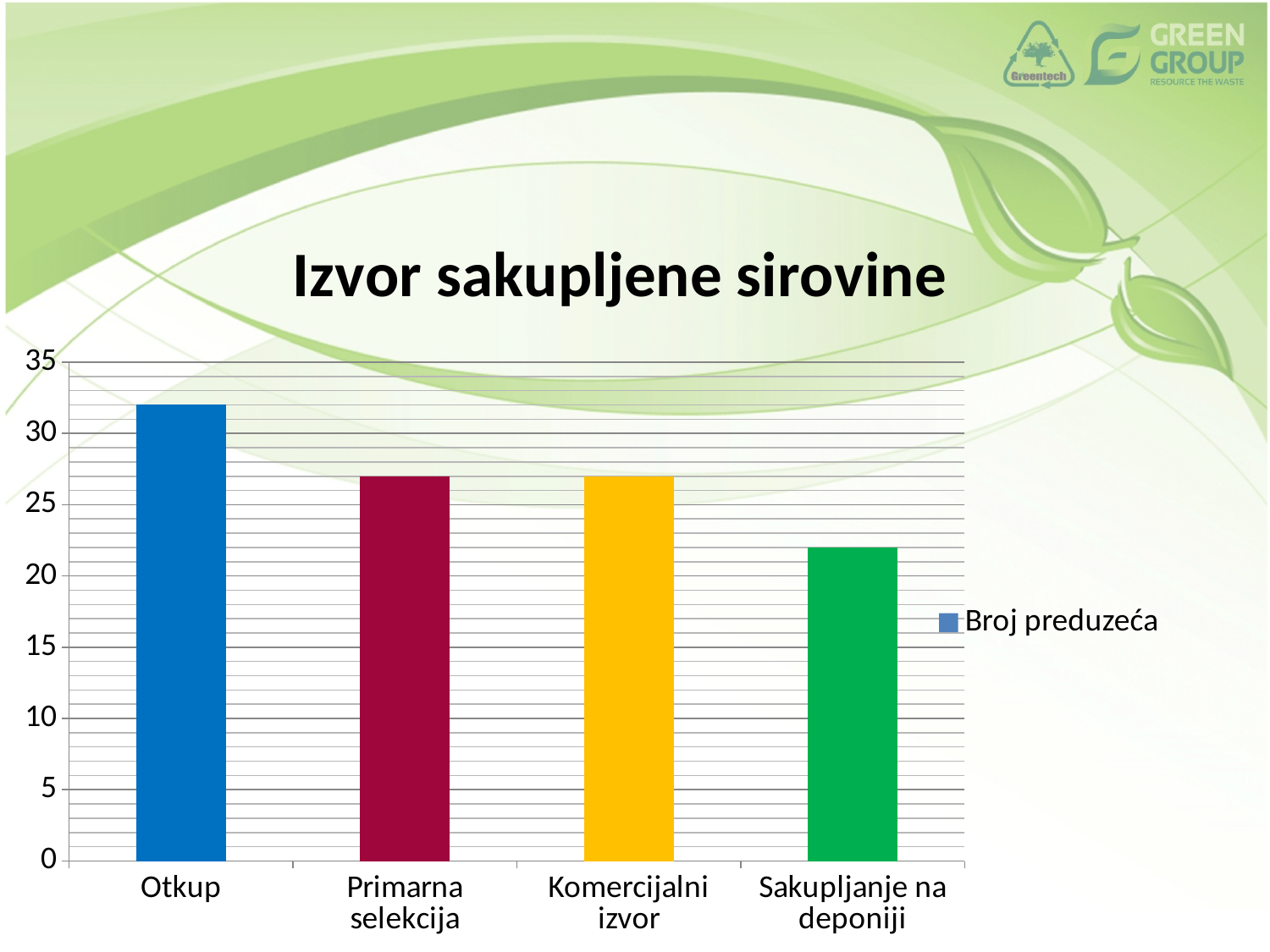
Is the value for Sakupljanje na deponiji greater or less than 25? less Is the value for Primarna selekcija greater or less than 25? greater Which category has the lowest value? Sakupljanje na deponiji What type of chart is shown on the slide? bar chart What is the title of the chart? Izvor sakupljene sirovine Which category has the highest value? Otkup How many series does the legend list? 1 How many categories are shown on the x axis of the chart? 4 Which is larger, the value for Otkup or the value for Sakupljanje na deponiji? Otkup Is the value for Otkup greater or less than 30? greater What is the name of the series shown in the legend? Broj preduzeća